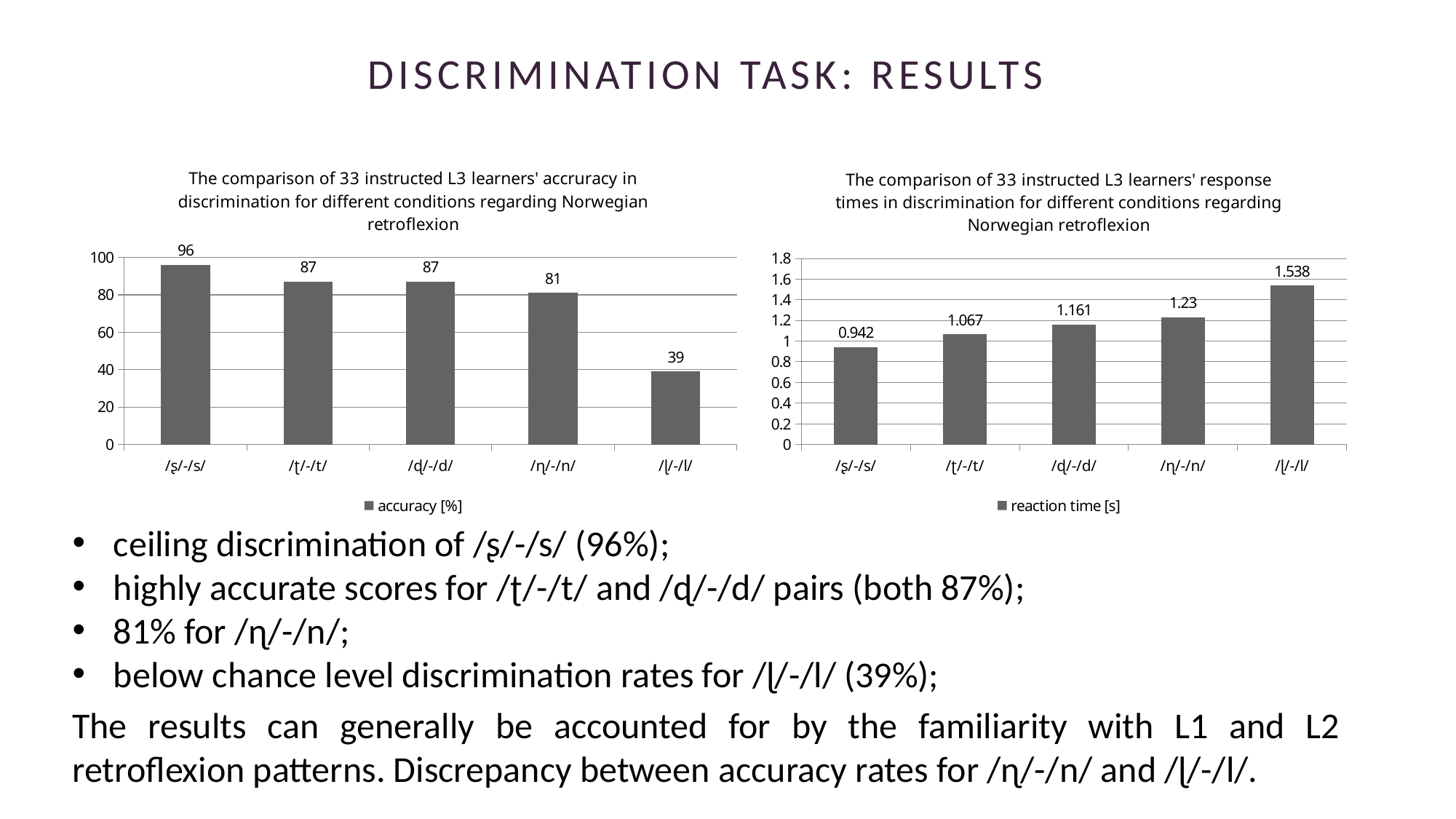
What is the legend entry of the right chart (response times)? reaction time [s] In the right chart (response times), which category has the lowest reaction time? /ʂ/-/s/ In the right chart (response times), do the reaction times rise or fall from left to right along the x axis? rise In the left chart (accuracy), what is the accuracy value for /ɳ/-/n/? 81 What type of chart is the left chart (accuracy)? bar chart In the left chart (accuracy), how many categories are shown on the x axis? 5 In the right chart (response times), what is the reaction time for /ɭ/-/l/? 1.538 In the left chart (accuracy), which category has the lowest accuracy? /ɭ/-/l/ In the left chart (accuracy), what is the accuracy value for /ʂ/-/s/? 96 In the right chart (response times), which is larger, the reaction time for /ɖ/-/d/ or for /ʈ/-/t/? /ɖ/-/d/ In the right chart (response times), what is the difference between the reaction times for /ɭ/-/l/ and /ʂ/-/s/? 0.596 In the left chart (accuracy), what is the difference between the accuracy for /ʂ/-/s/ and /ɭ/-/l/? 57